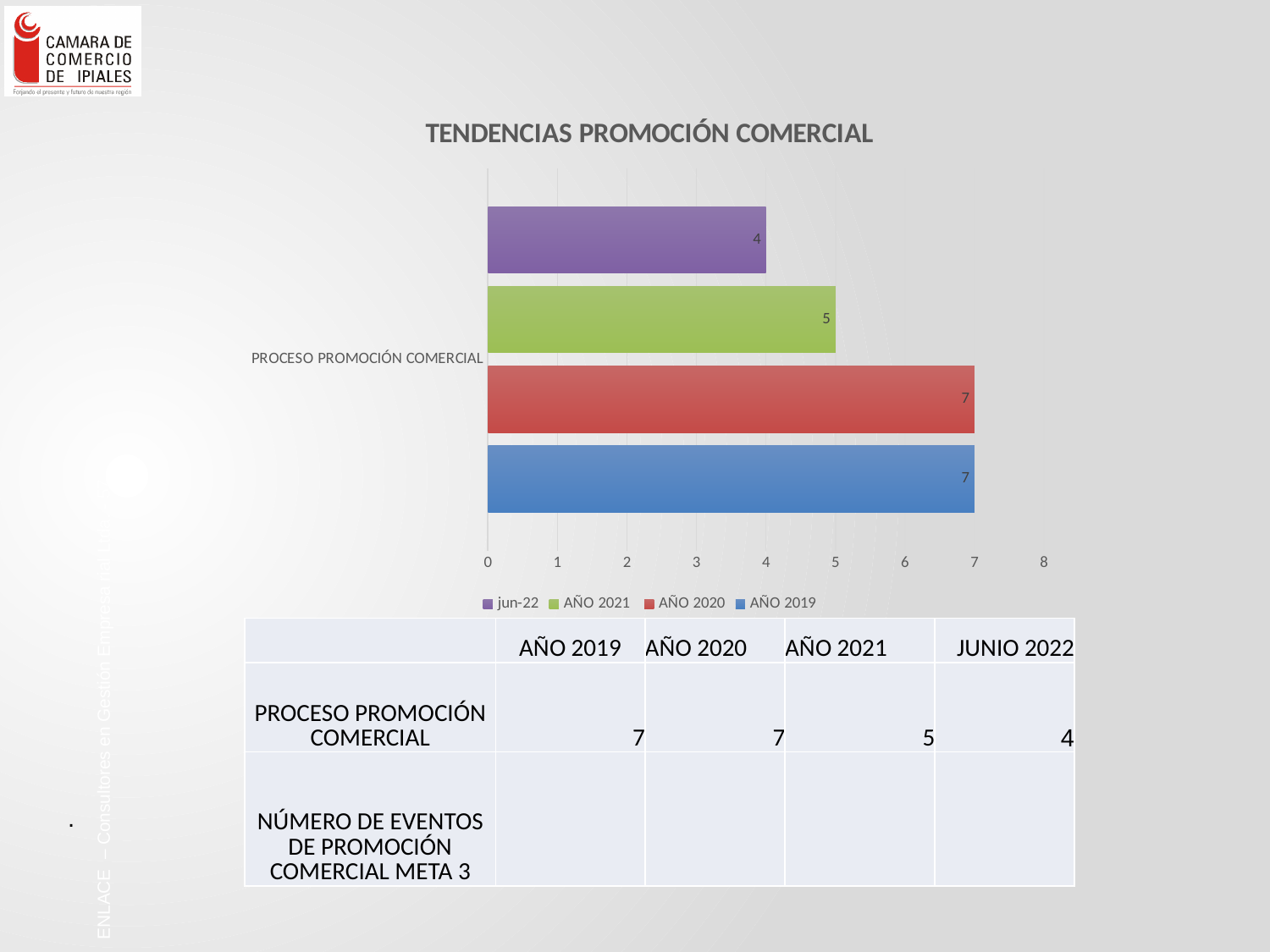
What is the title of the chart? TENDENCIAS PROMOCIÓN COMERCIAL What is the value for the jun-22 series in the chart? 4 Which series has the lowest value in the chart? jun-22 What is the difference between the AÑO 2020 value and the jun-22 value? 3 Which is larger, the AÑO 2021 value or the jun-22 value? AÑO 2021 What is the value for the AÑO 2021 series in the chart? 5 What is the difference between the AÑO 2019 value and the AÑO 2021 value? 2 How many series does the legend list? 4 Is the value for AÑO 2020 greater or less than 6? greater What kind of chart is shown on the slide? bar chart What is the value for the AÑO 2019 series in the chart? 7 What is the value for the AÑO 2020 series in the chart? 7